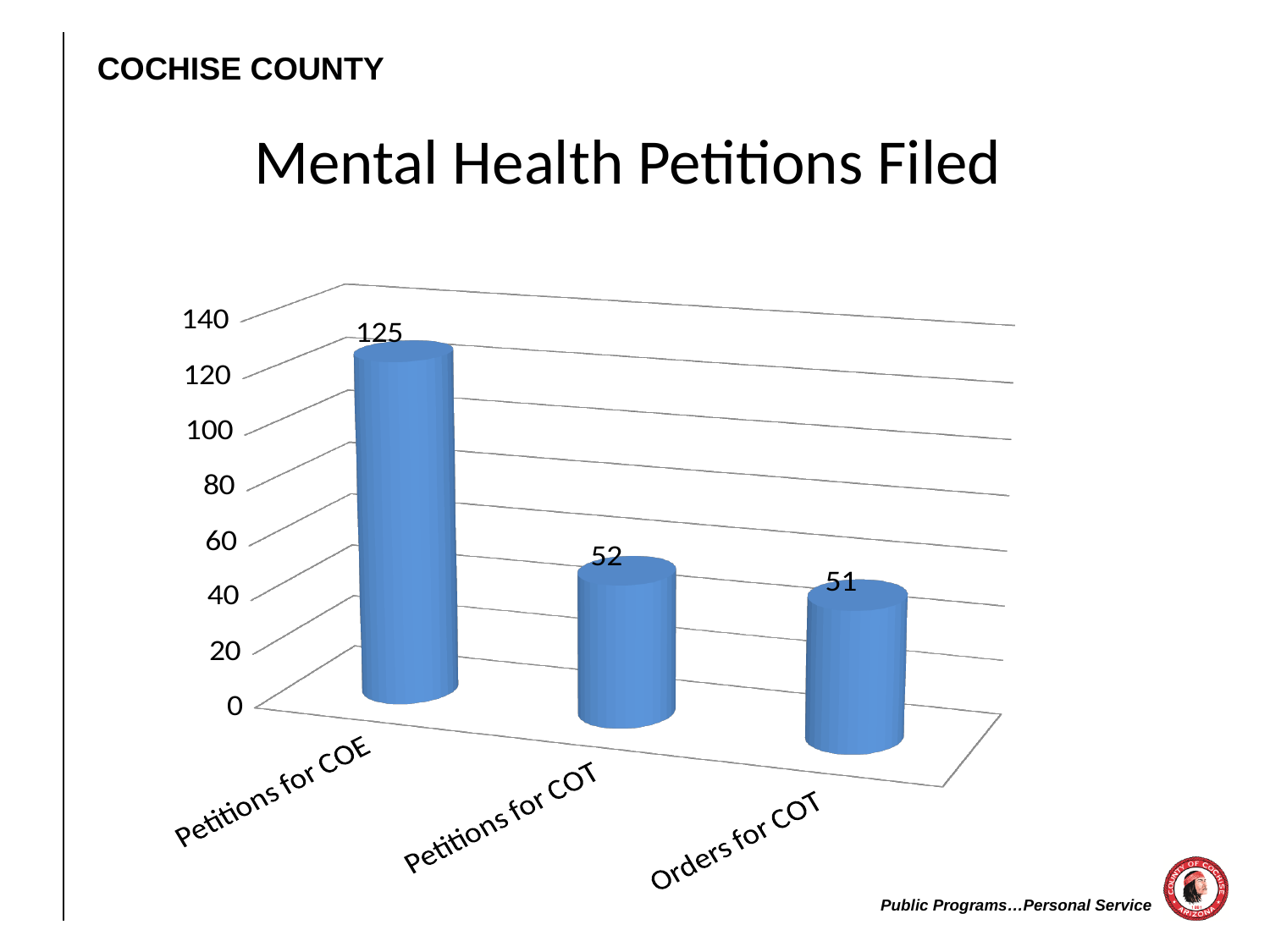
What is the value for Petitions for COE? 125 Which is larger, Petitions for COE or Orders for COT? Petitions for COE What kind of chart is shown on the slide? Bar chart Which category has the highest value? Petitions for COE Is the value for Orders for COT greater or less than 80? less What is the value for Petitions for COT? 52 What is the value for Orders for COT? 51 How many categories are shown in the chart? 3 What is the difference between Petitions for COE and Petitions for COT? 73 What is the difference between Petitions for COT and Orders for COT? 1 Is the value for Petitions for COE greater or less than 100? greater What is the title of the chart? Mental Health Petitions Filed